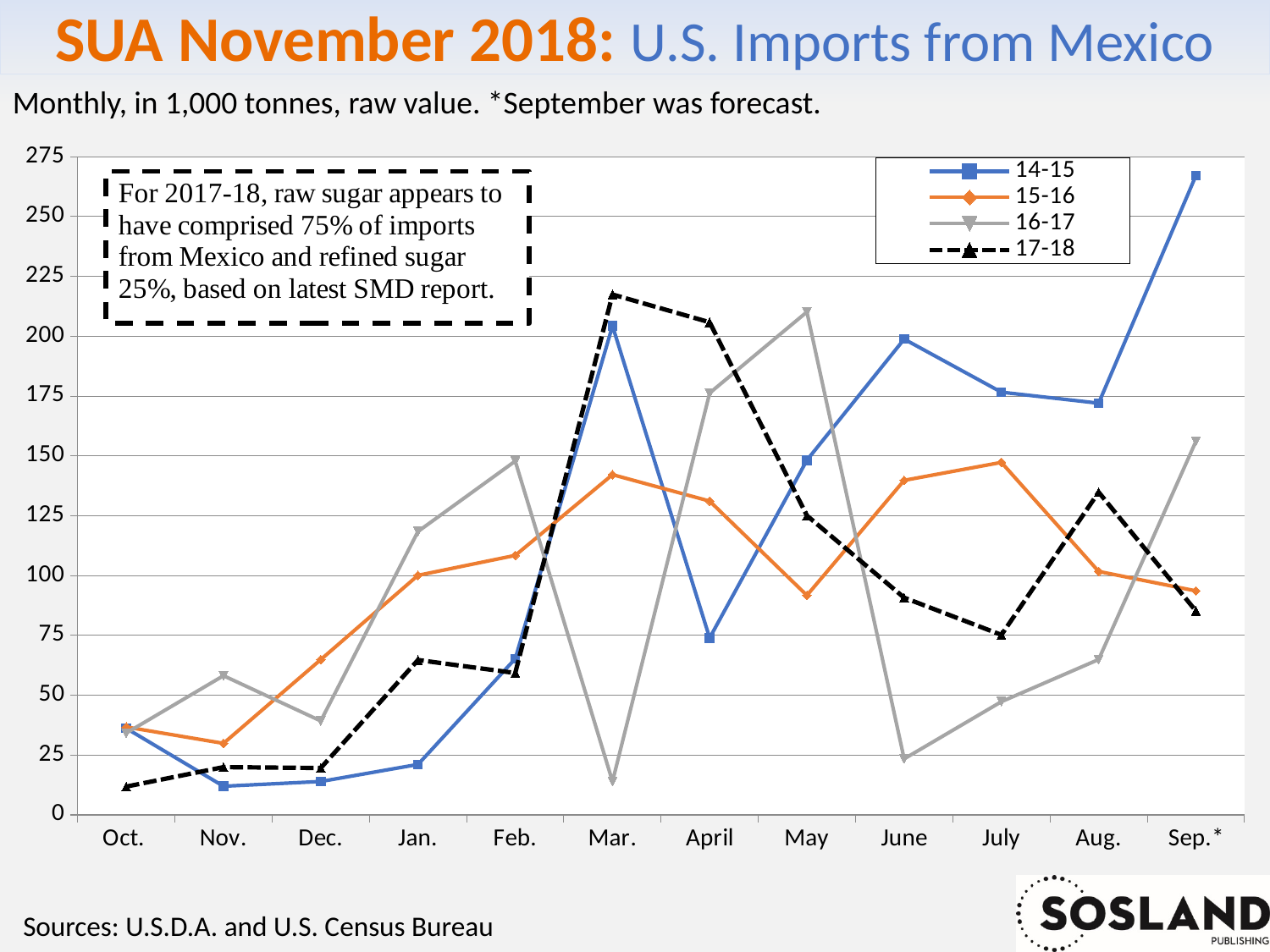
Is the value for the 16-17 series in Mar. greater or less than 25? less What kind of chart is shown on the slide? line chart Is the value for the 14-15 series in Sep.* greater or less than 250? greater Does the 15-16 series rise or fall from Oct. to Jan.? rise How many months are shown along the x axis? 12 In which month does the 14-15 series reach its highest value? Sep.* In which month does the 16-17 series reach its lowest value? Mar. In Mar., which series has the larger value, 17-18 or 15-16? 17-18 Which series is drawn with a dashed line? 17-18 In which month does the 17-18 series reach its highest value? Mar. Is the value for the 17-18 series in Oct. greater or less than 25? less How many series does the legend list? 4